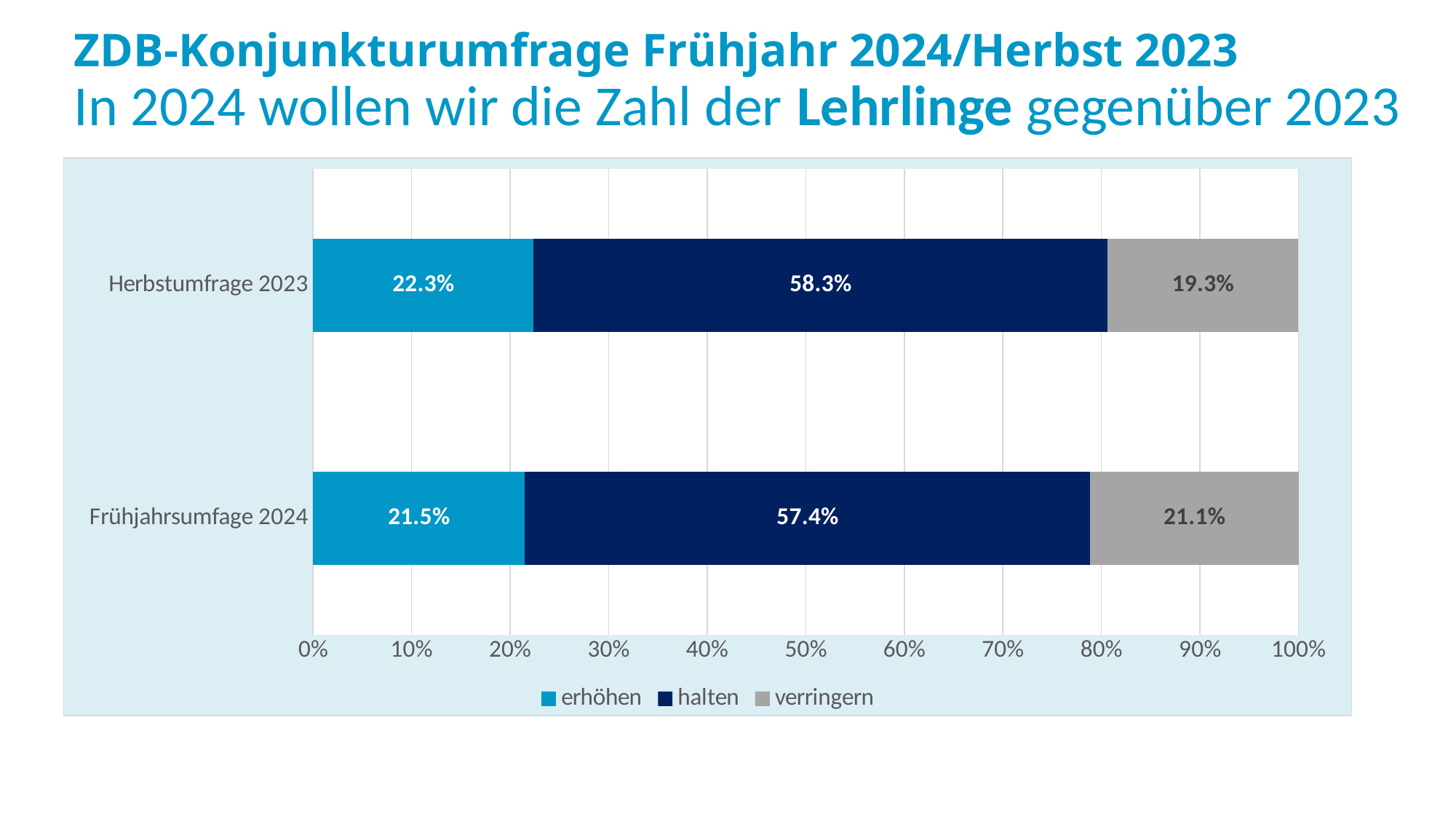
What kind of chart is shown on the slide? Stacked bar chart How many categories are shown on the chart? 2 Which series has the lowest value in Herbstumfrage 2023? verringern Which is larger: "verringern" in Herbstumfrage 2023 or "verringern" in Frühjahrsumfage 2024? Frühjahrsumfage 2024 What is the value for "erhöhen" in Frühjahrsumfage 2024? 21.5% Which series has the highest value in Frühjahrsumfage 2024? halten What is the difference between the "halten" values for Herbstumfrage 2023 and Frühjahrsumfage 2024? 0.9% What is the value for "halten" in Herbstumfrage 2023? 58.3% Which colour represents the "erhöhen" series? Light blue What is the value for "verringern" in Herbstumfrage 2023? 19.3% How many series does the legend list? 3 What is the value for "verringern" in Frühjahrsumfage 2024? 21.1%